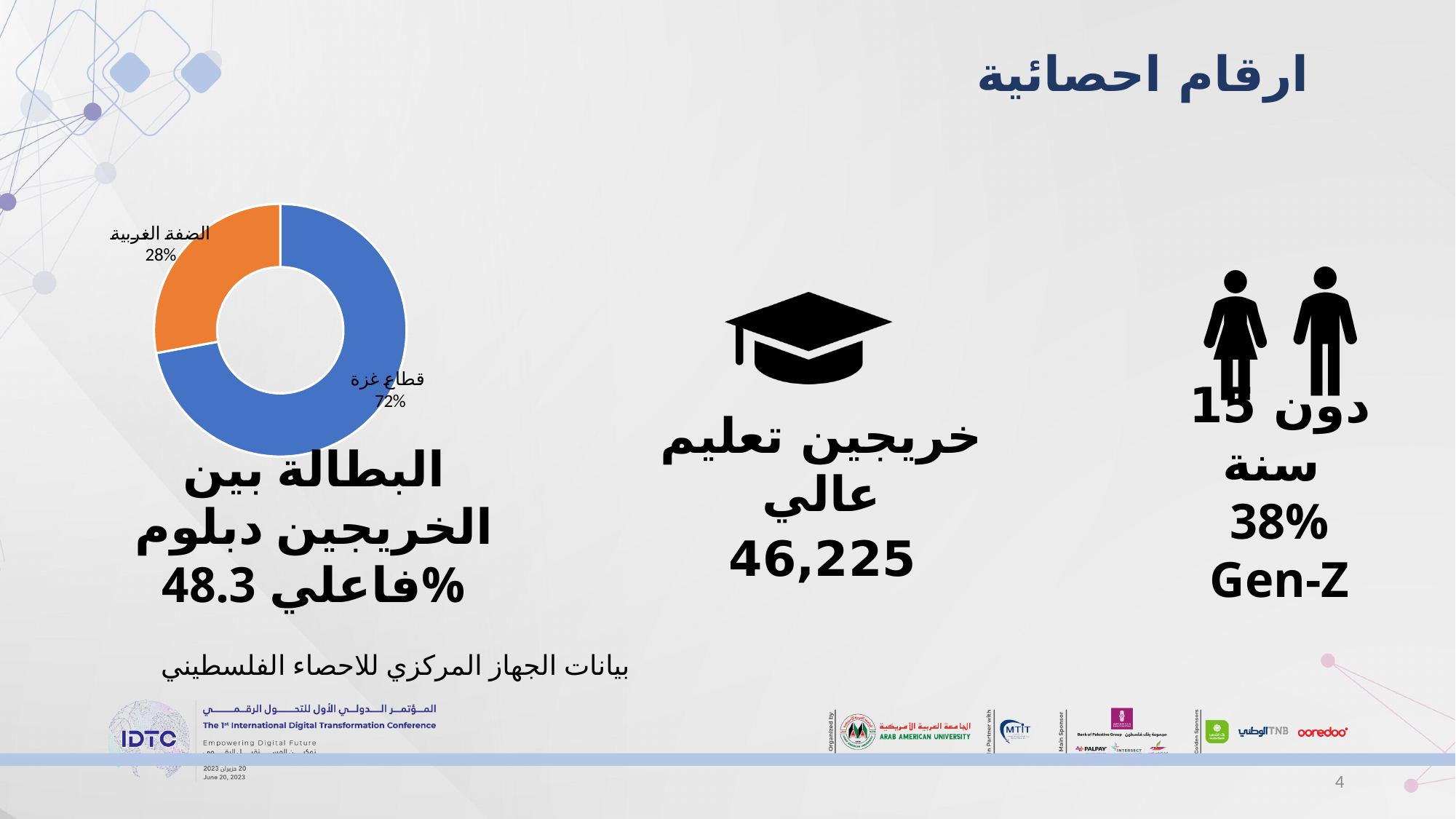
Which slice of the doughnut chart is the smallest? الضفة الغربية What percentage does the doughnut chart show for قطاع غزة? 72% In the doughnut chart, which is larger: قطاع غزة or الضفة الغربية? قطاع غزة Which slice of the doughnut chart is the largest? قطاع غزة What share of the doughnut chart does الضفة الغربية take? 28% What percentage does the doughnut chart show for الضفة الغربية? 28% How many slices does the doughnut chart have? 2 What colour is the الضفة الغربية slice in the doughnut chart? orange What is the difference in percentage points between قطاع غزة and الضفة الغربية in the doughnut chart? 44 What colour is the قطاع غزة slice in the doughnut chart? blue What kind of chart is shown on the left of the slide? doughnut chart